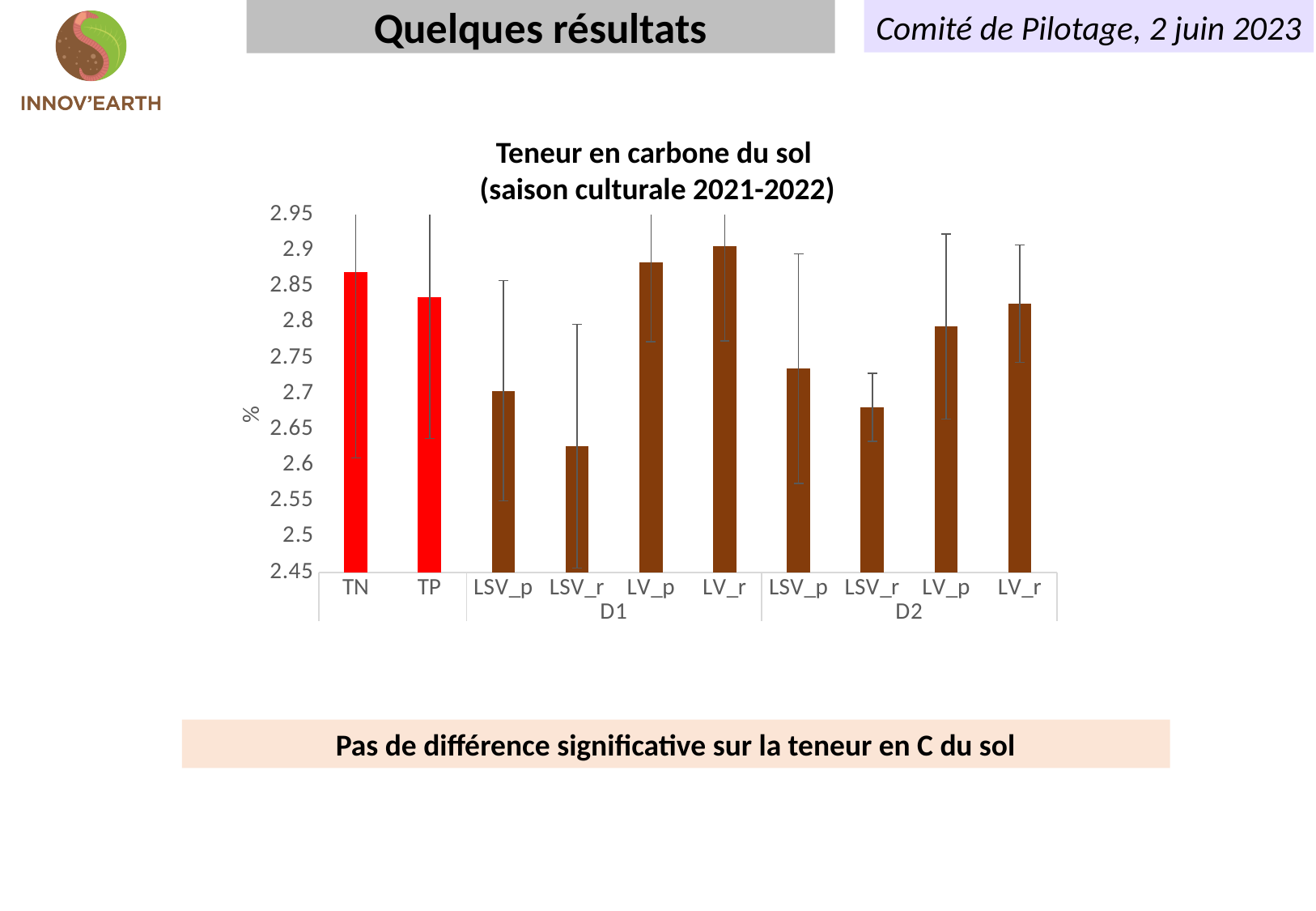
Which bar has the lowest value in the chart? LSV_r (D1) Is the value for LSV_r in group D2 greater or less than 2.75? less Is the value for LSV_r in group D1 greater or less than 2.65? less Which is larger, the value for LV_p in group D1 or the value for LSV_r in group D1? LV_p (D1) Is the value for LSV_p in group D1 greater or less than 2.75? less How many bars are plotted in the chart? 10 What is the label on the vertical axis of the chart? % What is the title of the chart? Teneur en carbone du sol (saison culturale 2021-2022) What kind of chart is shown on the slide? bar chart Which is larger, the value for TN or the value for LSV_p in group D2? TN